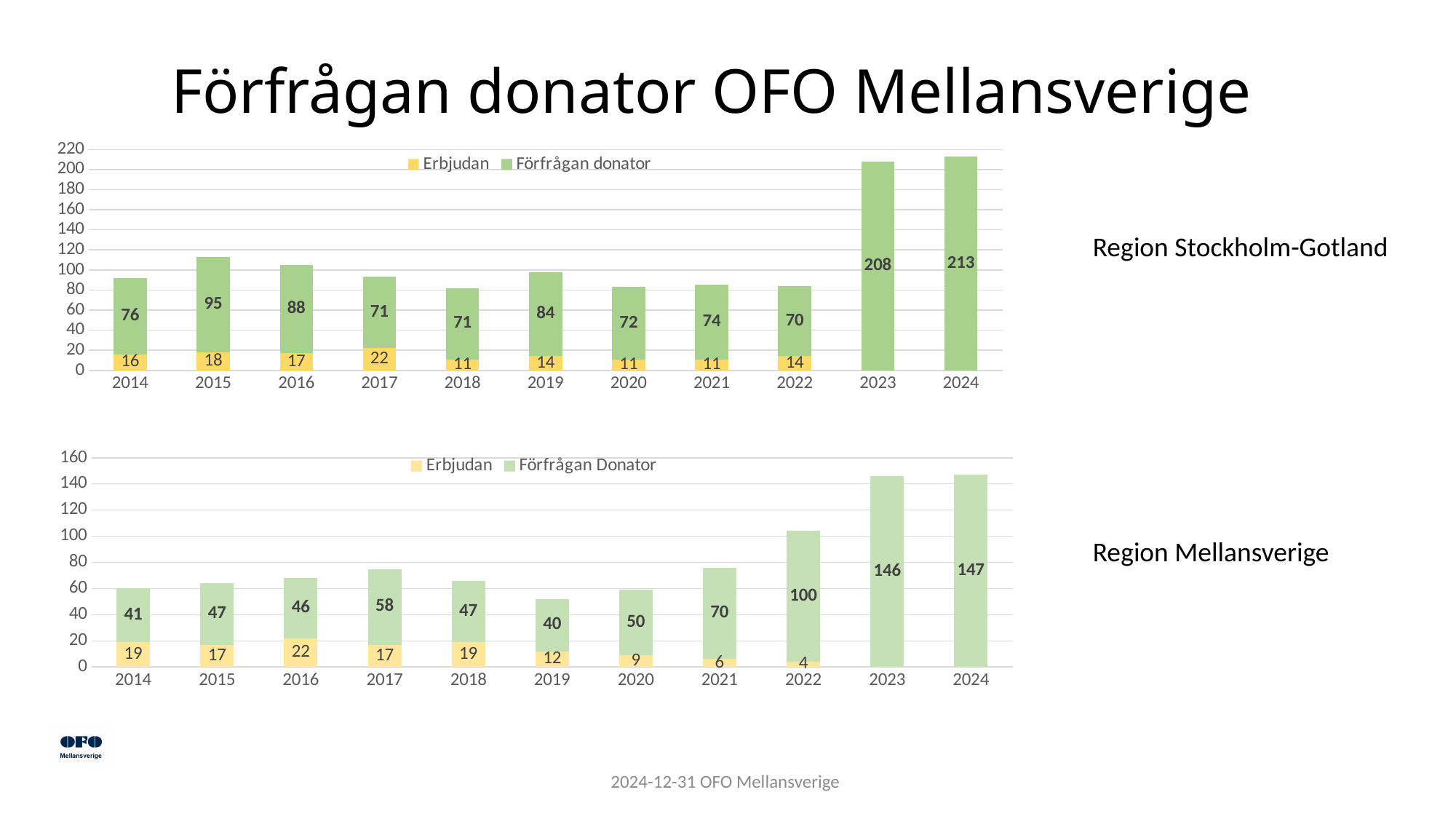
How many series does the legend of the bottom chart (Region Mellansverige) list? 2 How many years are shown on the x axis of the top chart (Region Stockholm-Gotland)? 11 In the bottom chart (Region Mellansverige), what is the Erbjudan value for 2016? 22 In the top chart (Region Stockholm-Gotland), which year has the highest Förfrågan donator value? 2024 In the top chart (Region Stockholm-Gotland), what is the Förfrågan donator value for 2015? 95 In the bottom chart (Region Mellansverige), which year has the lowest Erbjudan value? 2022 In the top chart (Region Stockholm-Gotland), what is the difference between the Förfrågan donator values for 2024 and 2023? 5 In the top chart (Region Stockholm-Gotland), what is the total of the stacked bar for 2017? 93 What kind of chart is the bottom chart (Region Mellansverige)? Stacked bar chart In the bottom chart (Region Mellansverige), do the Förfrågan Donator values rise or fall from 2021 to 2024? Rise In the bottom chart (Region Mellansverige), which year has the larger Förfrågan Donator value, 2019 or 2020? 2020 In the bottom chart (Region Mellansverige), what is the total of the stacked bar for 2021? 76